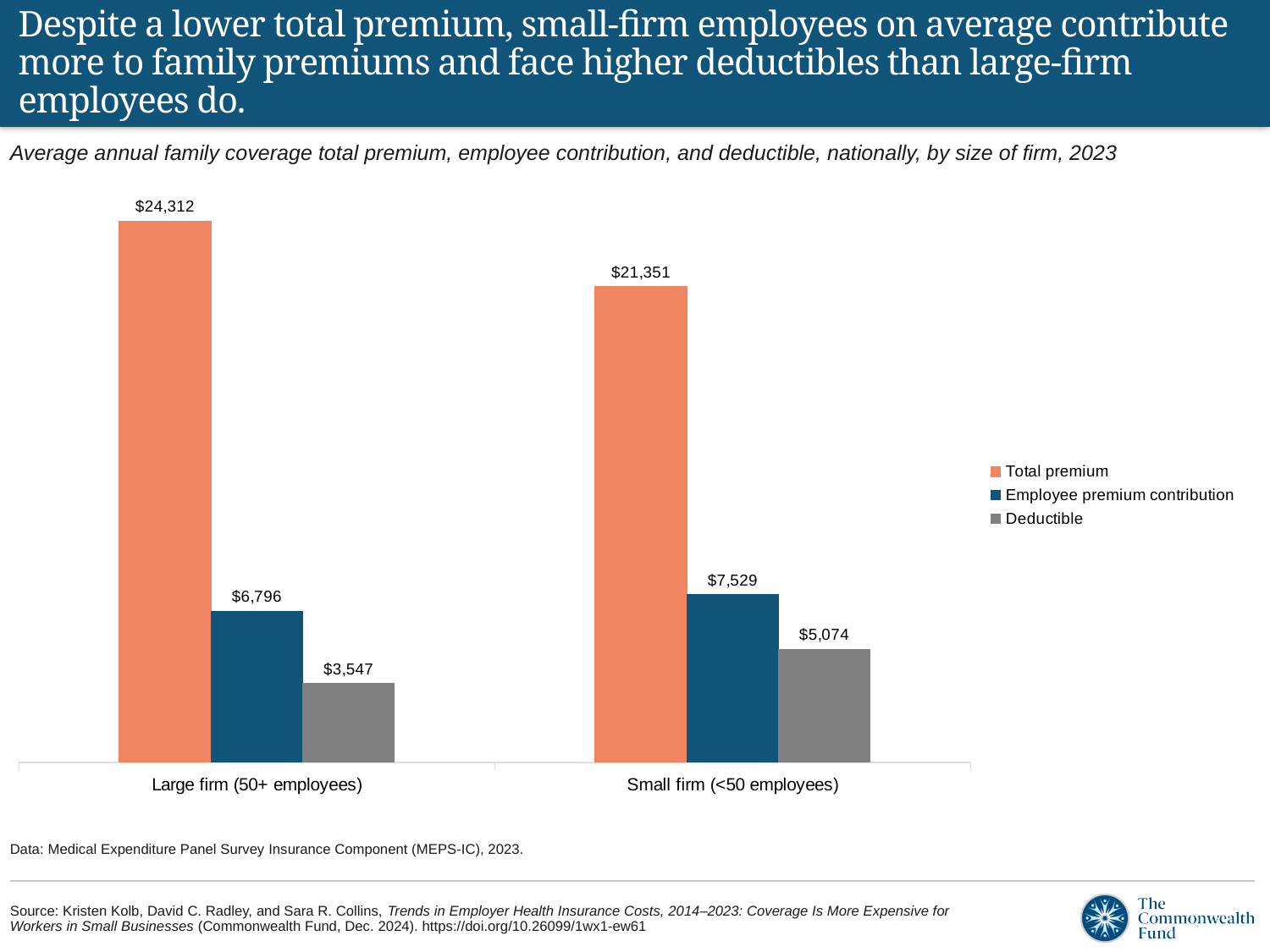
What is the total premium for small firms (<50 employees)? $21,351 How many firm-size categories are shown on the x axis? 2 Which firm size has the higher total premium? Large firm (50+ employees) How many series does the legend list? 3 What kind of chart is shown on the slide? Bar chart What is the deductible for large firms (50+ employees)? $3,547 What is the difference in total premium between large firms and small firms? $2,961 What is the total premium for large firms (50+ employees)? $24,312 What is the difference in employee premium contribution between small firms and large firms? $733 What is the difference in deductible between small firms and large firms? $1,527 Which firm size has the higher deductible? Small firm (<50 employees) What is the employee premium contribution for small firms (<50 employees)? $7,529